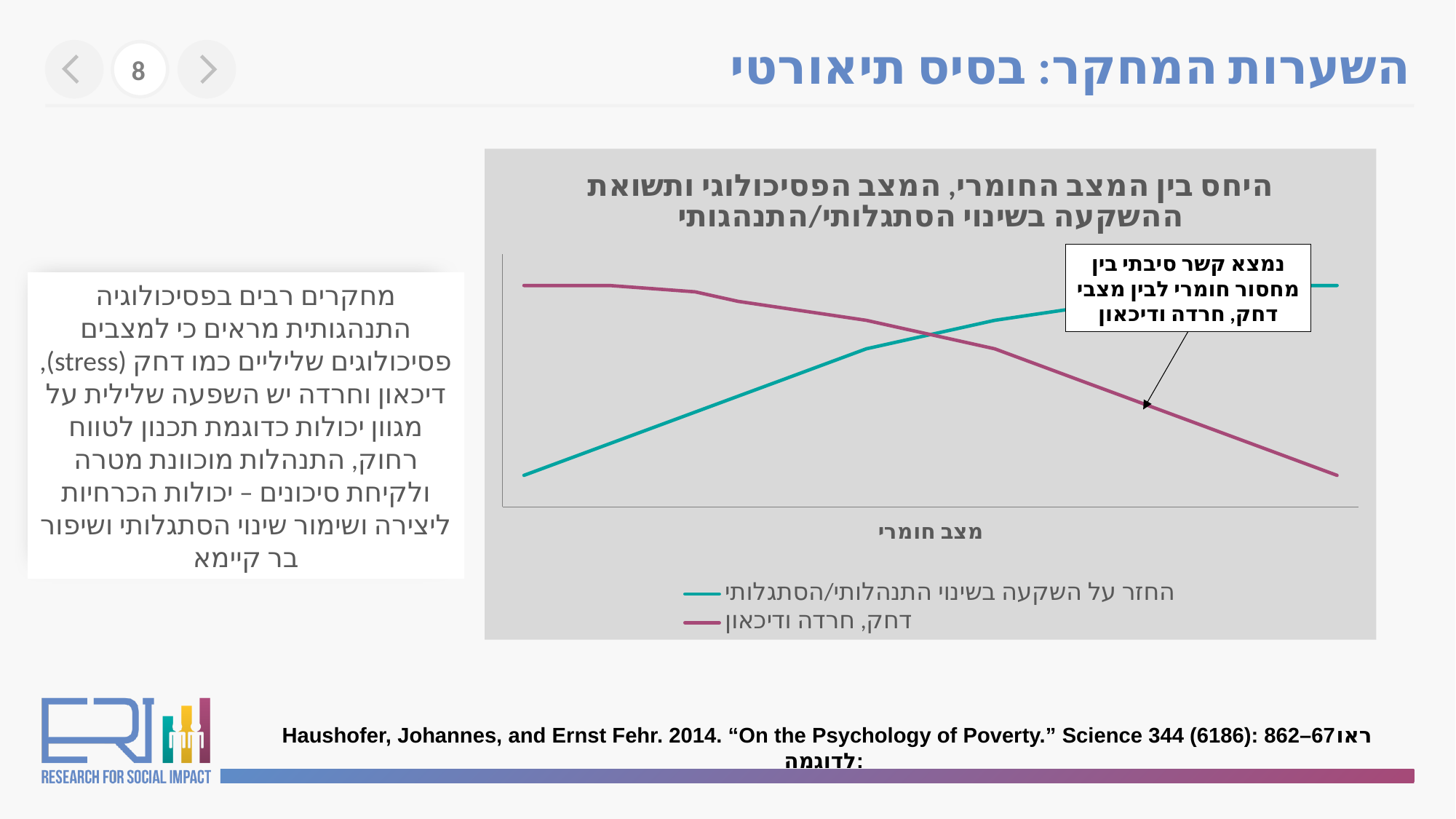
What kind of chart is shown on the slide? Line chart How many series does the chart's legend list? 2 Does the line for "דחק, חרדה ודיכאון" rise or fall as the material condition (מצב חומרי) increases along the x axis? Falls Do the two lines in the chart cross each other? Yes Does the line for "החזר על השקעה בשינוי התנהלותי/הסתגלותי" rise or fall as the material condition (מצב חומרי) increases along the x axis? Rises What is the label of the chart's x axis? מצב חומרי At the left end of the x axis, which series has the higher value: "דחק, חרדה ודיכאון" or "החזר על השקעה בשינוי התנהלותי/הסתגלותי"? דחק, חרדה ודיכאון At the right end of the x axis, which series has the higher value: "דחק, חרדה ודיכאון" or "החזר על השקעה בשינוי התנהלותי/הסתגלותי"? החזר על השקעה בשינוי התנהלותי/הסתגלותי Which colour is used for the "דחק, חרדה ודיכאון" line in the chart? Purple